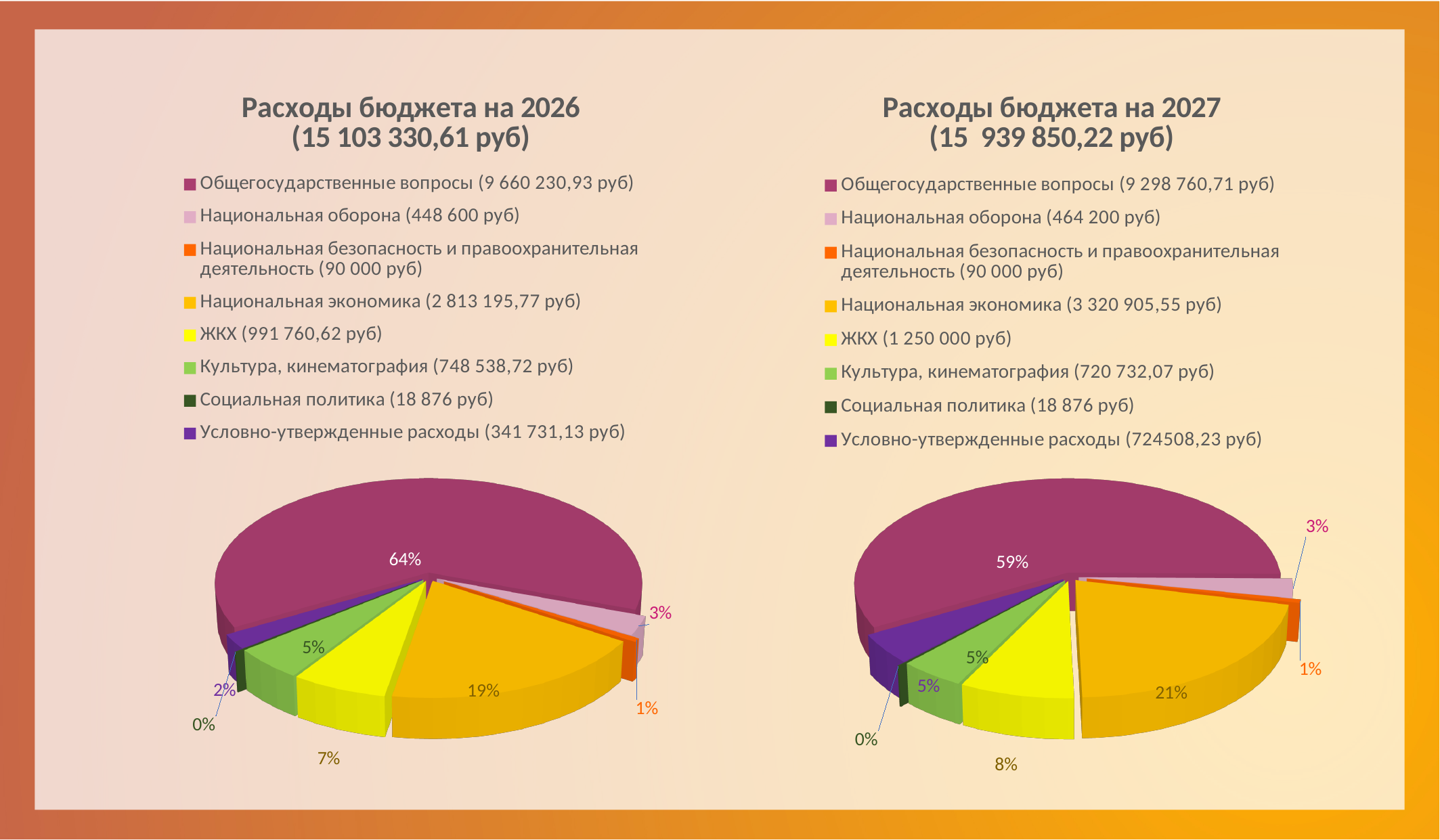
In the 'Расходы бюджета на 2027' chart, what is the value shown in the legend for 'ЖКХ'? 1 250 000 руб In the 'Расходы бюджета на 2027' chart, what share of the pie does 'Национальная экономика' take? 21% What total amount is shown in the title of the 'Расходы бюджета на 2027' chart? 15 939 850,22 руб In the 'Расходы бюджета на 2027' chart, what share of the pie does 'Условно-утвержденные расходы' take? 5% How many categories does the legend of the 'Расходы бюджета на 2027' chart list? 8 In the 'Расходы бюджета на 2026' chart, which category has the smallest slice? Социальная политика In the 'Расходы бюджета на 2026' chart, what share of the pie does 'Общегосударственные вопросы' take? 64% In the 'Расходы бюджета на 2027' chart, which category has the largest slice? Общегосударственные вопросы What kind of chart is used on the slide for 'Расходы бюджета на 2026'? pie chart In the 'Расходы бюджета на 2026' chart, which is larger: the share for 'ЖКХ' or the share for 'Культура, кинематография'? ЖКХ What is the difference between the share of 'Общегосударственные вопросы' in the 2026 chart and in the 2027 chart? 5% In the 'Расходы бюджета на 2026' chart, what is the value shown in the legend for 'Национальная экономика'? 2 813 195,77 руб